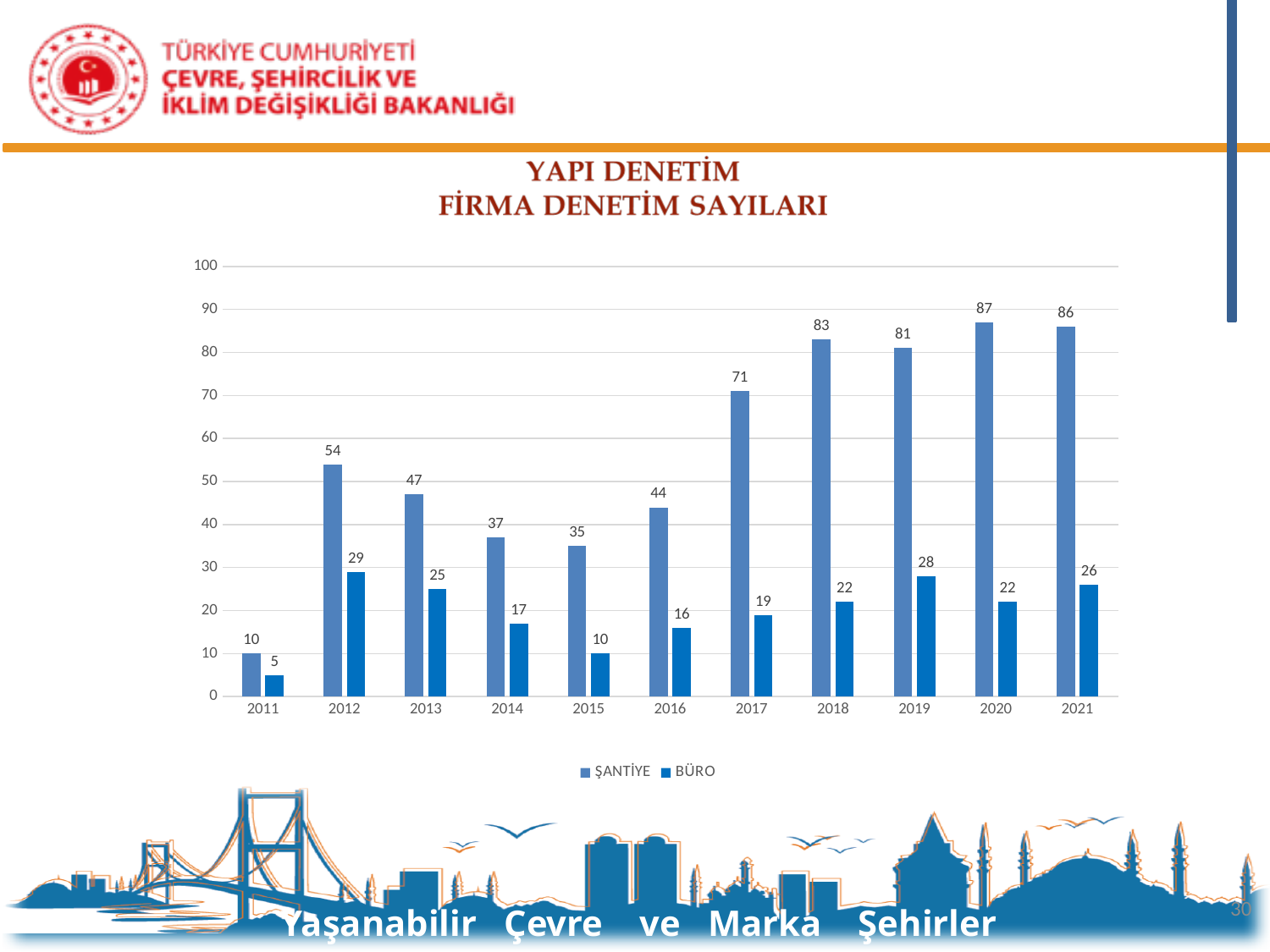
Does the ŞANTİYE value rise or fall from 2017 to 2018? rise What is the difference between the ŞANTİYE and BÜRO values in 2021? 60 What kind of chart is shown on the slide? bar chart What is the BÜRO value for 2019? 28 How many series does the legend list? 2 What is the ŞANTİYE value for 2017? 71 Which year has the lowest BÜRO value? 2011 Which is larger, the ŞANTİYE value for 2012 or the ŞANTİYE value for 2013? 2012 Is the ŞANTİYE value for 2018 greater or less than 80? greater How many years are shown on the x axis? 11 Which year has the highest ŞANTİYE value? 2020 What is the title of the chart? YAPI DENETİM FİRMA DENETİM SAYILARI